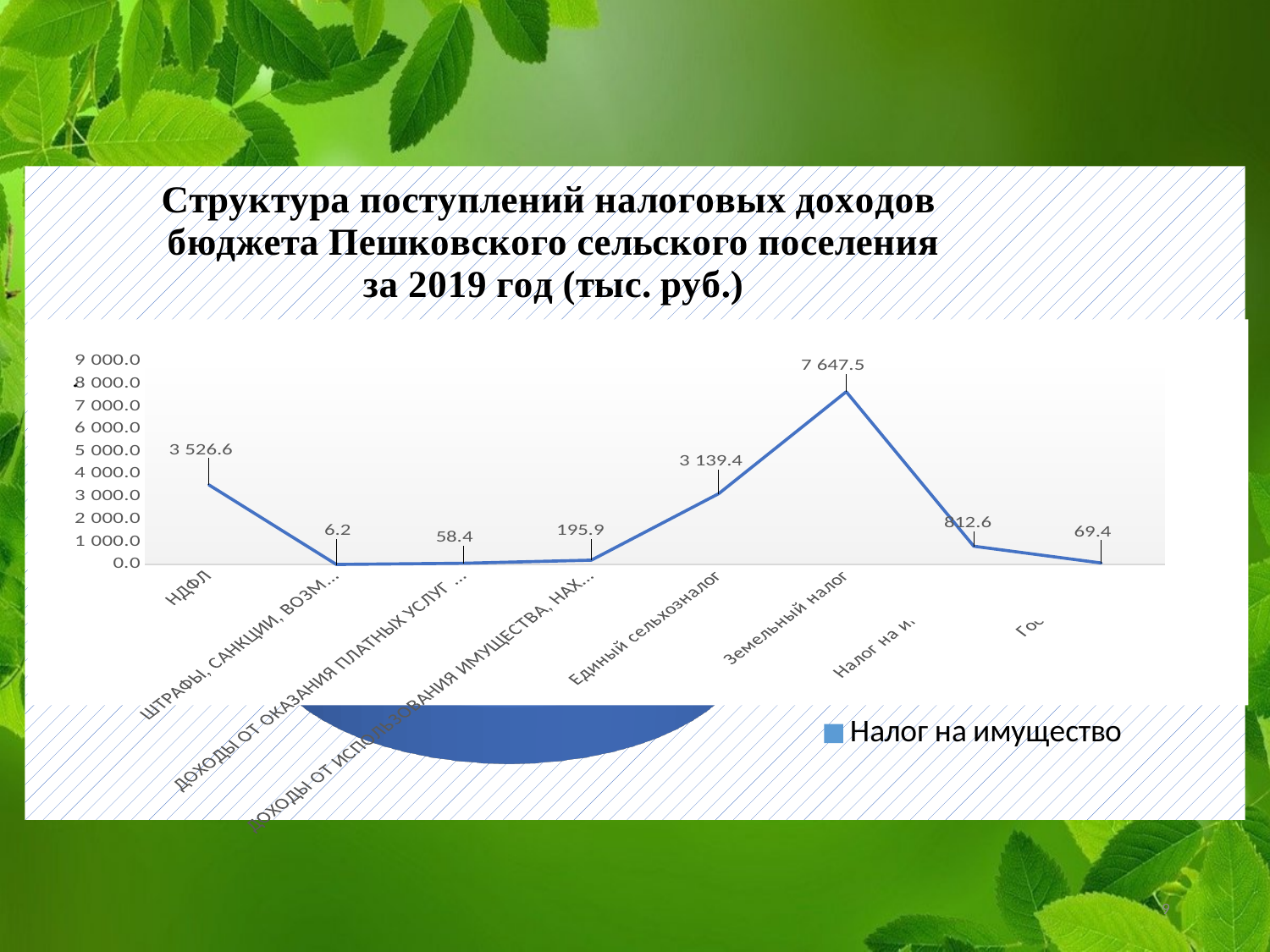
Which category has the lowest value on the line chart? ШТРАФЫ, САНКЦИИ, ВОЗМ... What is the value for Единый сельхозналог? 3 139.4 Is the value for Земельный налог greater or less than 7 000.0? greater What is the difference between the values for Земельный налог and НДФЛ? 4 120.9 What is the value for the category labelled 58.4 on the chart, ДОХОДЫ ОТ ОКАЗАНИЯ ПЛАТНЫХ УСЛУГ? 58.4 What year does the chart title say the data is for? 2019 Which category has the highest value on the line chart? Земельный налог What is the value for НДФЛ? 3 526.6 How many data points are plotted on the line chart? 8 What kind of chart is used to show the tax revenue structure? line chart What is the value for Земельный налог? 7 647.5 Which is larger, the value for НДФЛ or the value for Единый сельхозналог? НДФЛ